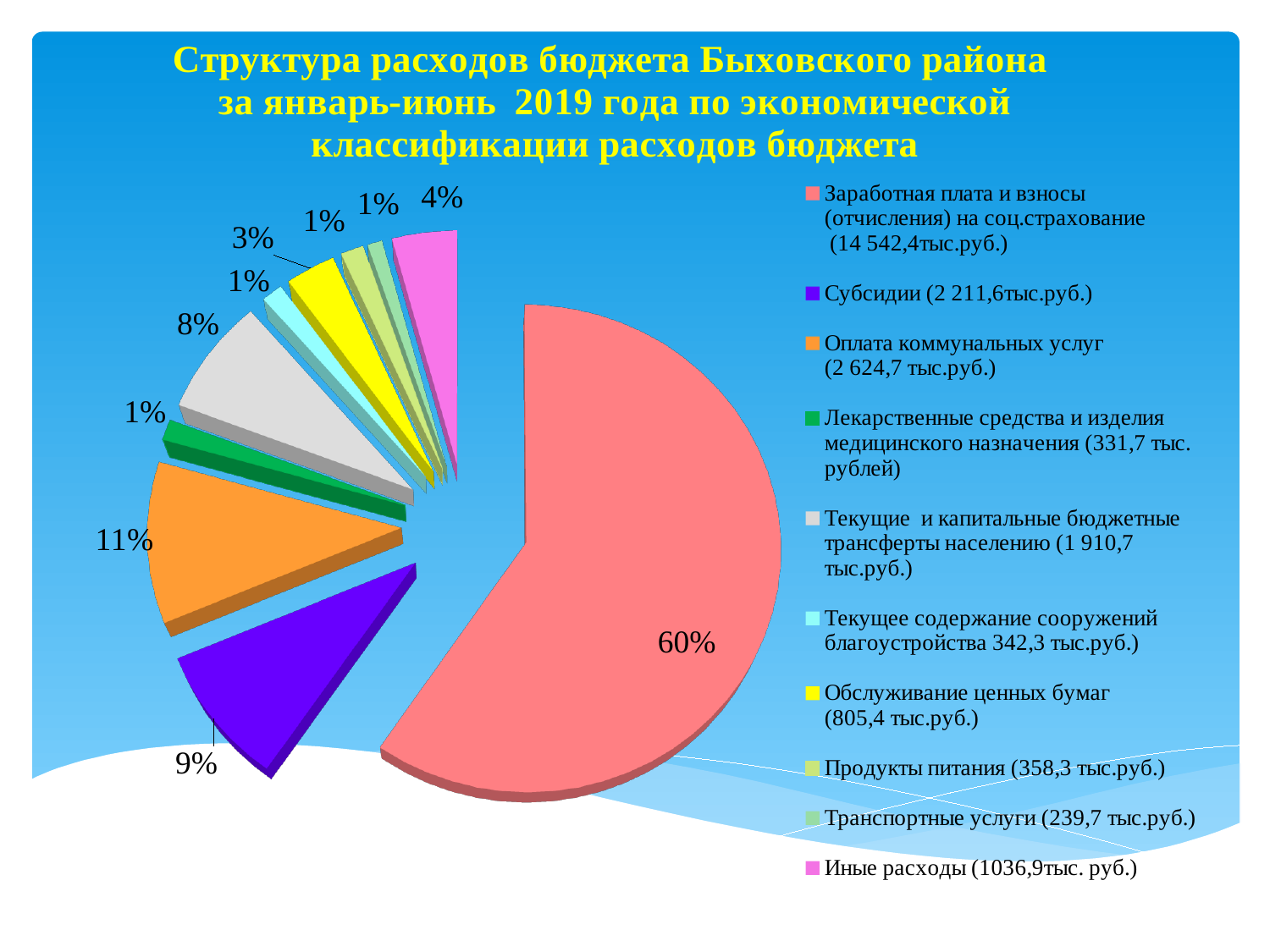
What share of the pie does "Иные расходы" have? 4% What share of the pie does "Заработная плата и взносы (отчисления) на соц.страхование" have? 60% How many categories does the legend list? 10 What share of the pie does "Субсидии" have? 9% What kind of chart is shown on the slide? pie chart Which category has the largest slice of the pie? Заработная плата и взносы (отчисления) на соц.страхование Which is larger: the slice for "Оплата коммунальных услуг" or the slice for "Субсидии"? Оплата коммунальных услуг What amount in thousand rubles is given in the legend for "Субсидии"? 2 211,6 What is the difference in percentage points between the "Заработная плата и взносы" slice and the "Оплата коммунальных услуг" slice? 49